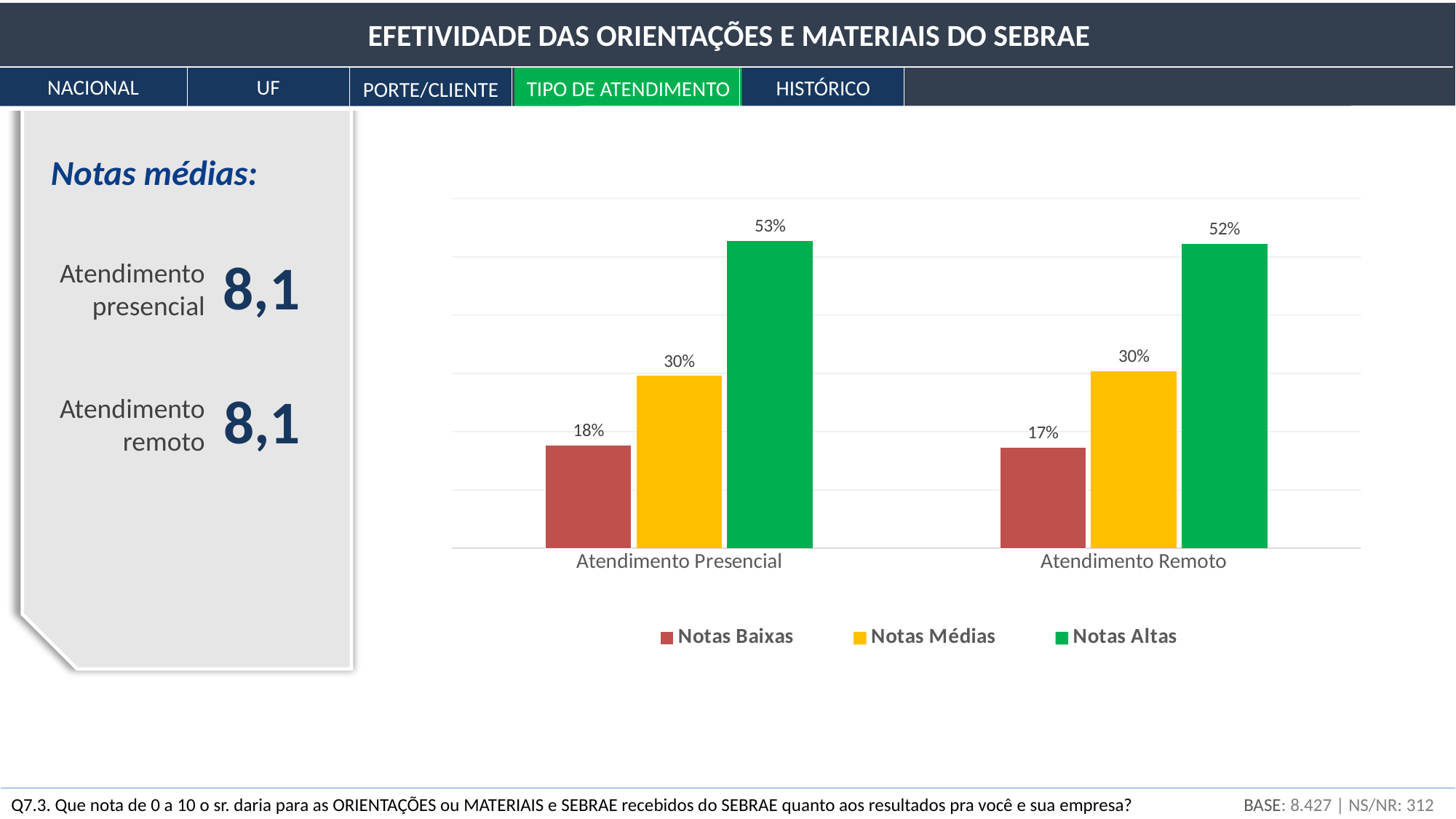
What kind of chart is shown on the slide? Bar chart Which series has the highest value in the Atendimento Remoto group? Notas Altas What is the value for Notas Altas in the Atendimento Presencial group? 53% What is the difference between Notas Baixas for Atendimento Presencial and Atendimento Remoto? 1% Which is larger: Notas Altas for Atendimento Presencial or Notas Altas for Atendimento Remoto? Atendimento Presencial Which series has the lowest value in the Atendimento Presencial group? Notas Baixas What is the value for Notas Altas in the Atendimento Remoto group? 52% How many categories are shown on the x axis of the chart? 2 What is the value for Notas Médias in the Atendimento Presencial group? 30% What is the value for Notas Baixas in the Atendimento Remoto group? 17% How many series does the legend list? 3 What is the difference between Notas Altas and Notas Baixas in the Atendimento Presencial group? 35%